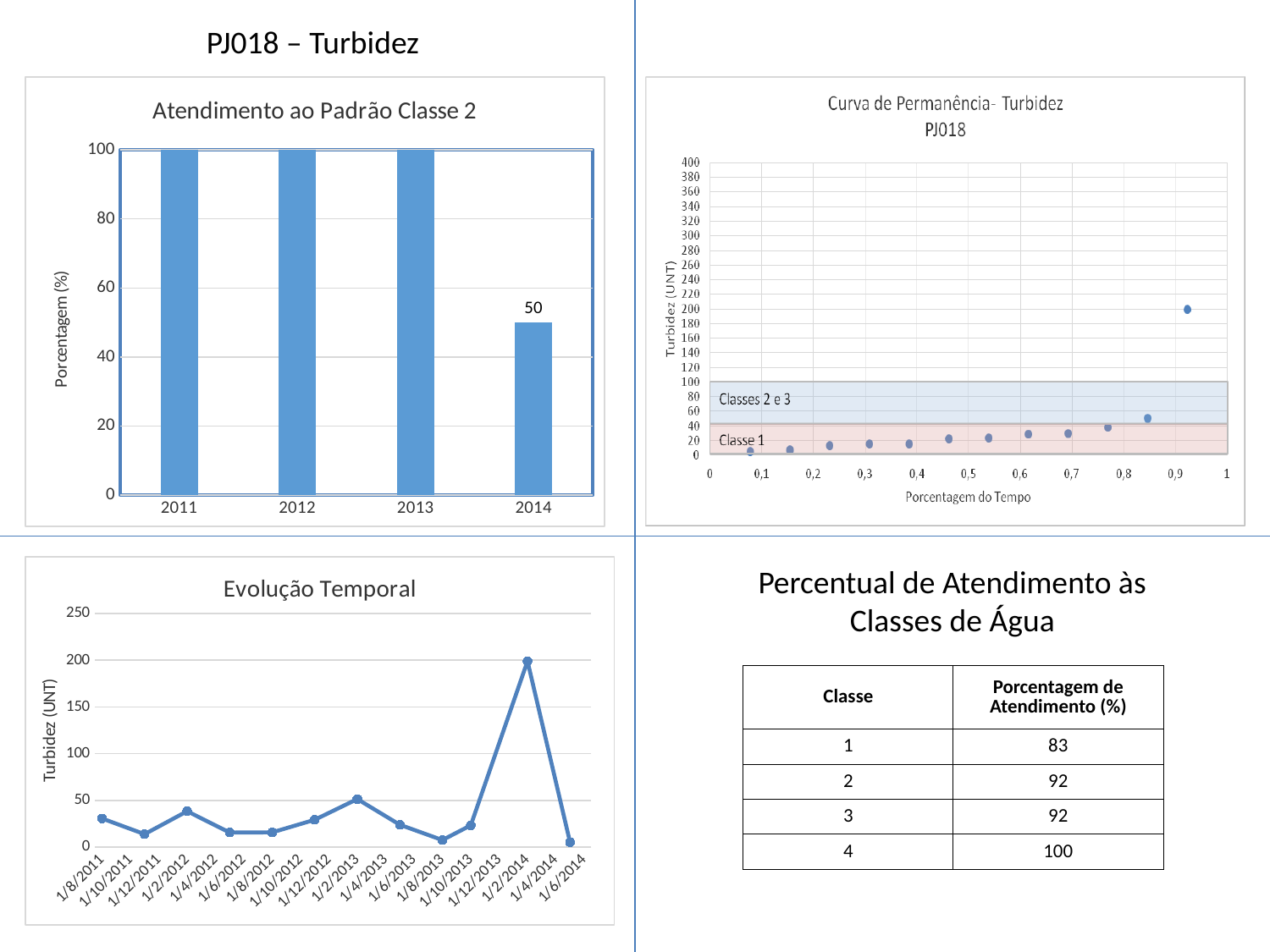
In the 'Evolução Temporal' chart, is the value for 1/8/2013 greater or less than 50? less In the 'Curva de Permanência - Turbidez PJ018' chart, what is the y-axis label? Turbidez (UNT) In the 'Atendimento ao Padrão Classe 2' chart, what is the value for 2014? 50 In the 'Atendimento ao Padrão Classe 2' chart, what is the value for 2011? 100 What kind of chart is 'Evolução Temporal'? line chart In the 'Atendimento ao Padrão Classe 2' chart, what is the difference between the values for 2013 and 2014? 50 What kind of chart is 'Atendimento ao Padrão Classe 2'? bar chart In the 'Atendimento ao Padrão Classe 2' chart, how many years are shown on the x axis? 4 In the 'Evolução Temporal' chart, which date has the highest turbidity value? 1/2/2014 In the 'Atendimento ao Padrão Classe 2' chart, which year has the lowest value? 2014 In the 'Curva de Permanência - Turbidez PJ018' chart, how many data points are plotted? 12